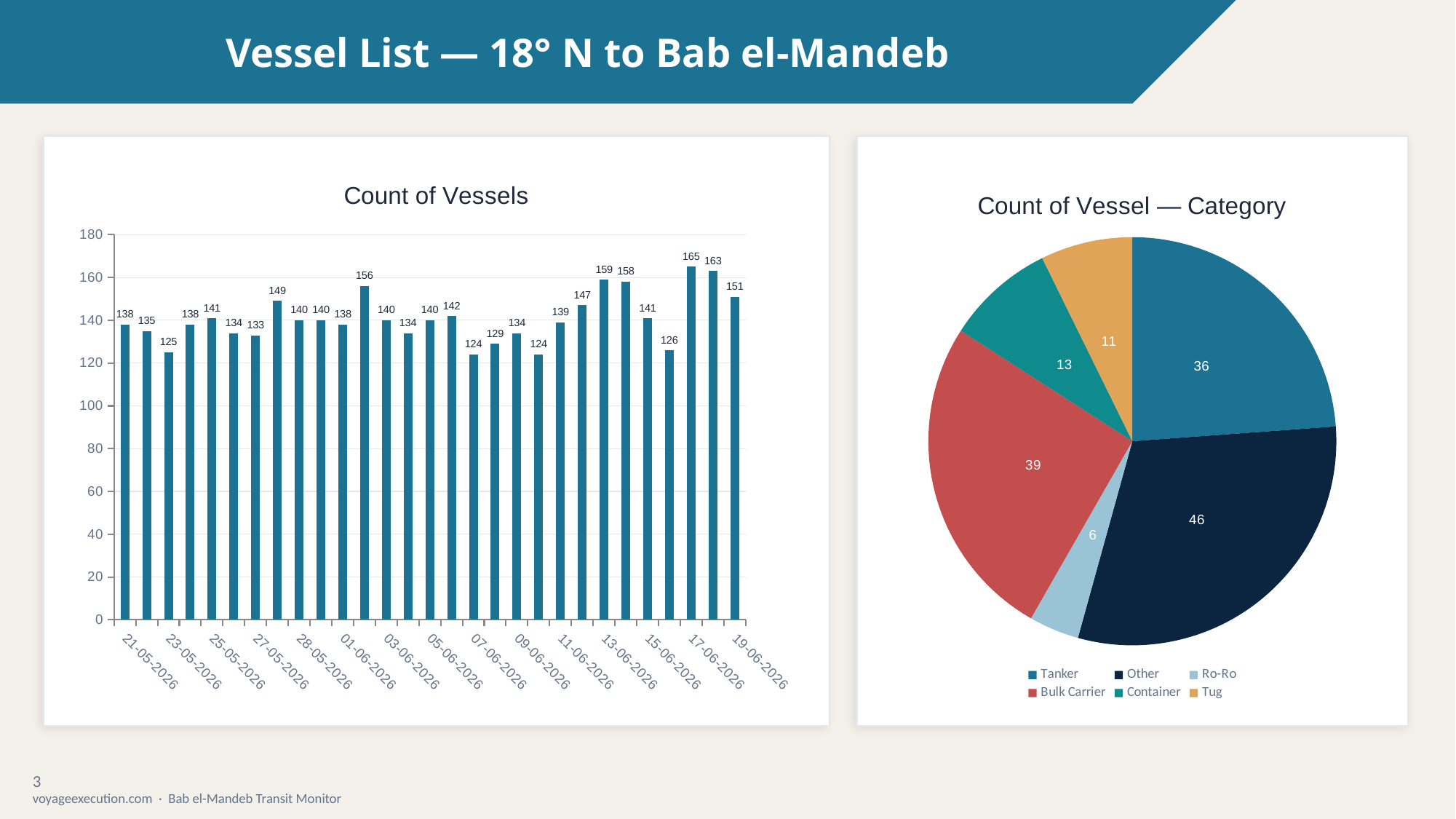
In the "Count of Vessel — Category" pie chart, which category has the smallest slice? Ro-Ro In the "Count of Vessel — Category" pie chart, which is larger, Tanker or Bulk Carrier? Bulk Carrier What kind of chart is the "Count of Vessels" chart on the left? bar chart How many bars are plotted in the "Count of Vessels" bar chart? 29 In the "Count of Vessel — Category" pie chart, what is the difference between the Other and Tanker values? 10 In the "Count of Vessels" bar chart, what is the highest value shown? 165 What kind of chart is the "Count of Vessel — Category" chart on the right? pie chart In the "Count of Vessels" bar chart, what is the lowest value shown? 124 In the "Count of Vessel — Category" pie chart, which category has the largest slice? Other In the "Count of Vessels" bar chart, what is the value of the last bar, for 19-06-2026? 151 How many categories does the legend of the "Count of Vessel — Category" pie chart list? 6 In the "Count of Vessel — Category" pie chart, what is the value for Bulk Carrier? 39